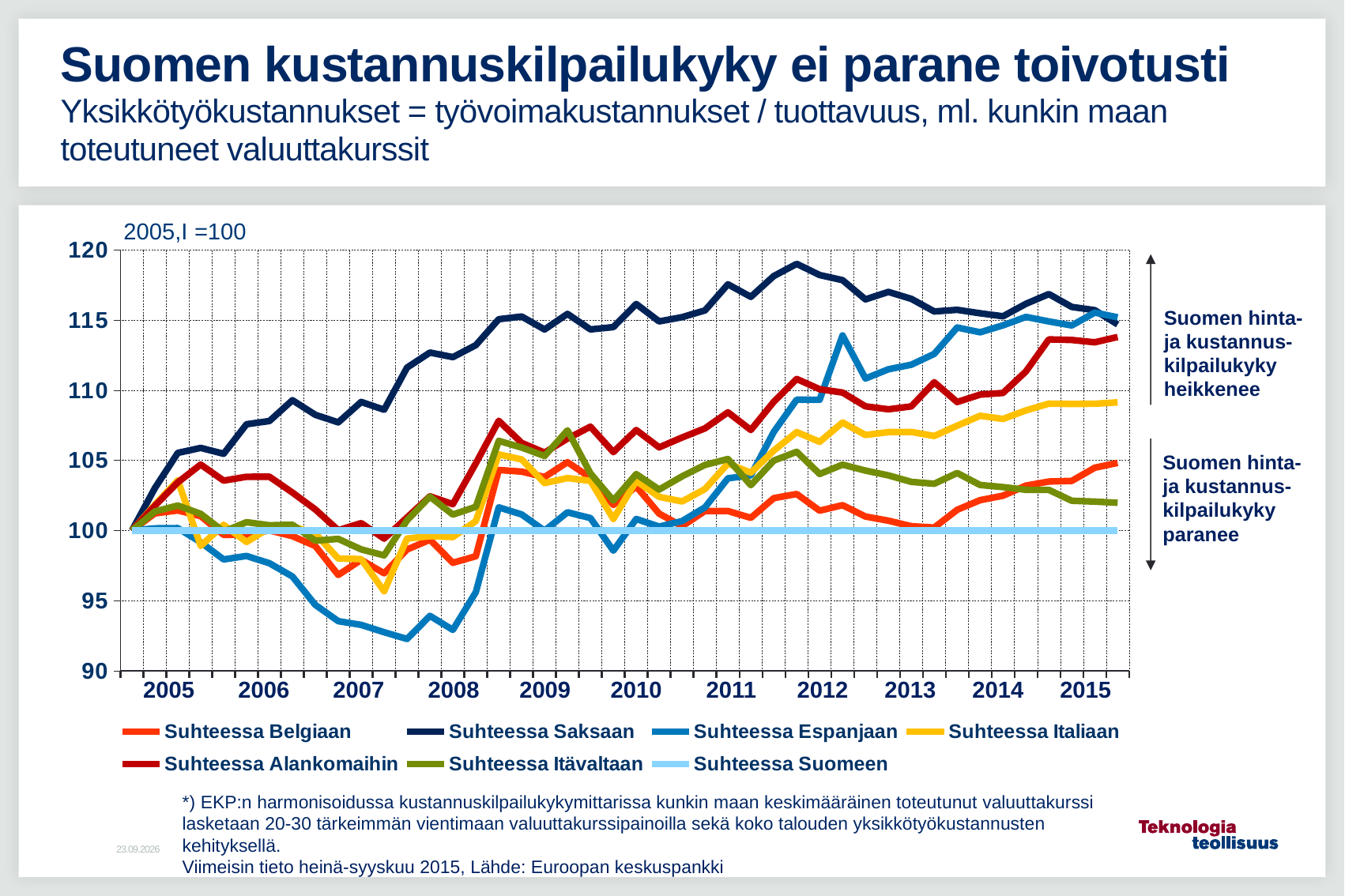
Which series is the highest in 2012? Suhteessa Saksaan Is the value for Suhteessa Espanjaan in 2007 greater or less than 95? less Is the value for Suhteessa Itävaltaan in 2015 greater or less than 105? less Does the Suhteessa Saksaan line rise or fall from 2005 to 2012? rise Is the value for Suhteessa Saksaan in 2012 greater or less than 115? greater In 2014, which is larger: Suhteessa Alankomaihin or Suhteessa Belgiaan? Suhteessa Alankomaihin How many series does the legend list? 7 Which series is the lowest in 2007? Suhteessa Espanjaan How many year labels are shown on the x axis? 11 What constant value does the Suhteessa Suomeen line hold across the whole period? 100 What is the index base stated above the chart? 2005,I =100 What type of chart is shown on the slide? line chart